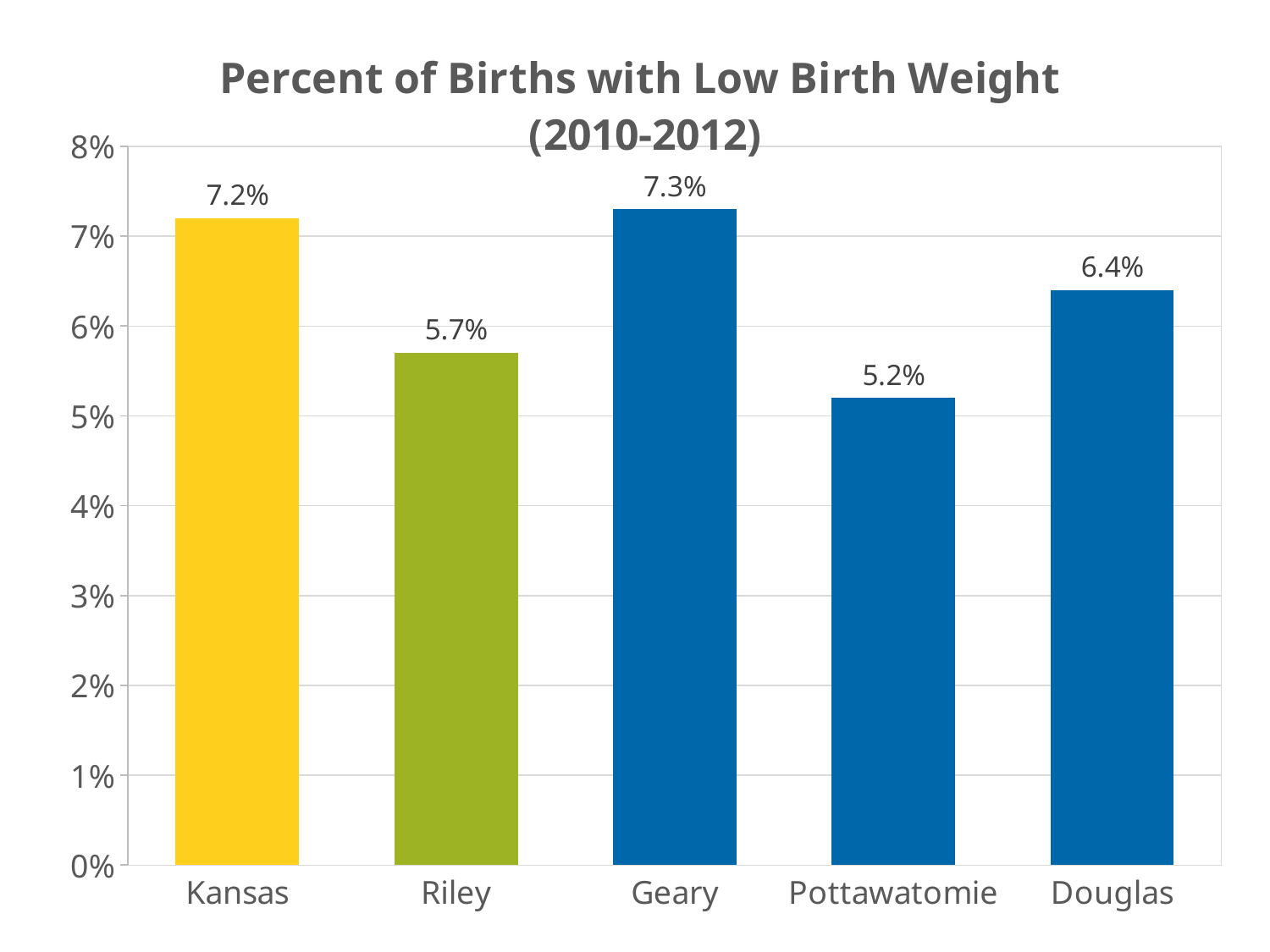
What is the difference between the values for Douglas and Pottawatomie? 1.2% What kind of chart is shown on the slide? Bar chart How many categories are shown on the chart? 5 What is the difference between the values for Kansas and Riley? 1.5% What is the percent of births with low birth weight for Douglas? 6.4% What is the percent of births with low birth weight for Riley? 5.7% Which has a larger value, Riley or Douglas? Douglas Which category has the lowest percent of births with low birth weight? Pottawatomie What is the percent of births with low birth weight for Pottawatomie? 5.2% Is the value for Geary greater or less than 7%? greater Which category has the highest percent of births with low birth weight? Geary What is the percent of births with low birth weight for Kansas? 7.2%